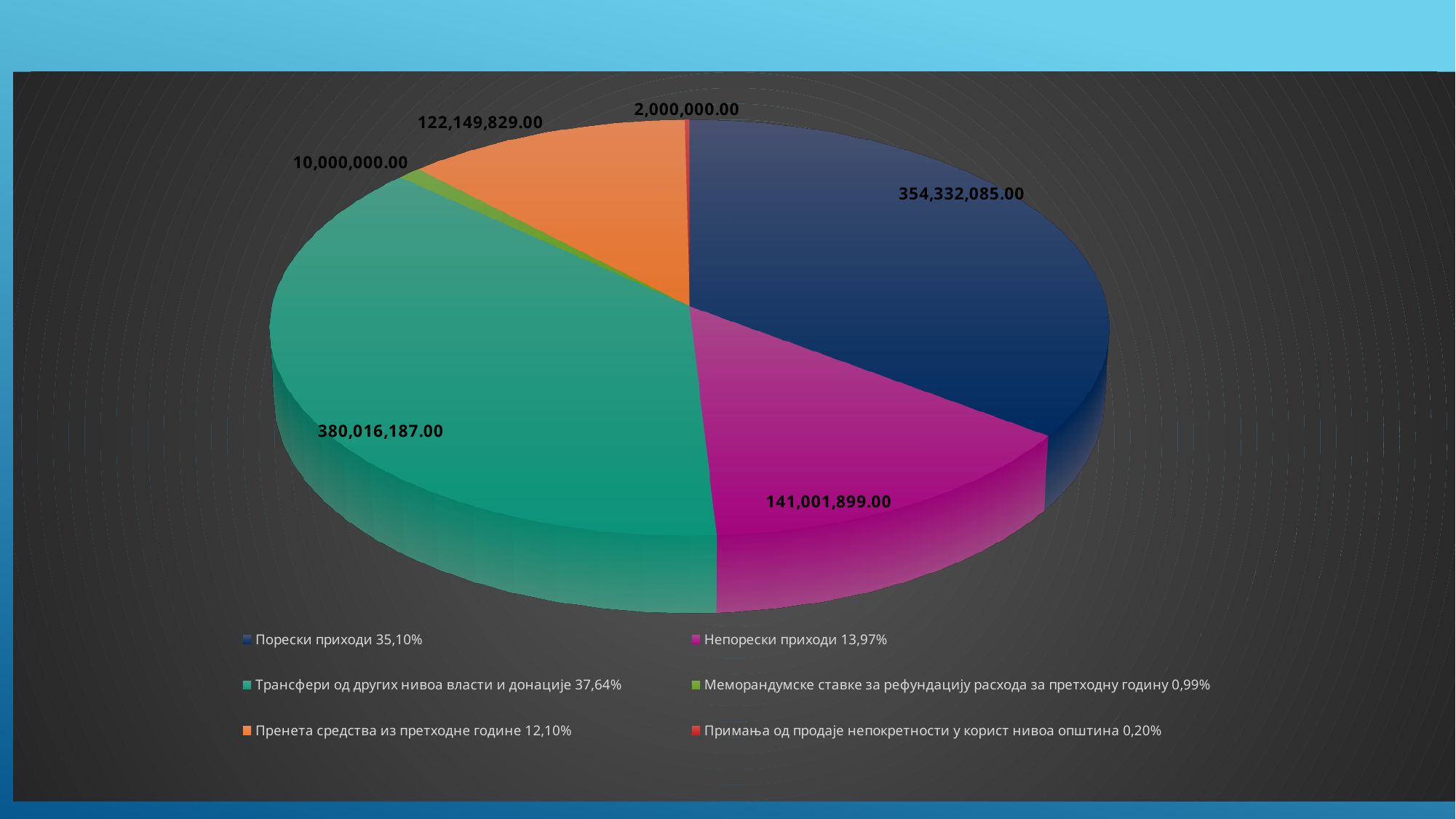
What is the value of the Непорески приходи slice? 141,001,899.00 What is the difference between the Трансфери од других нивоа власти и донације value and the Порески приходи value? 25,684,102.00 What is the value of the Порески приходи slice? 354,332,085.00 How many slices does the pie chart have? 6 What is the value of the Трансфери од других нивоа власти и донације slice? 380,016,187.00 Which category has the largest slice of the pie? Трансфери од других нивоа власти и донације What type of chart is shown on the slide? pie chart What share of the pie does Пренета средства из претходне године represent, according to the legend? 12,10% What colour is the Непорески приходи slice? magenta Which is larger, the Порески приходи slice or the Непорески приходи slice? Порески приходи Which category has the smallest slice of the pie? Примања од продаје непокретности у корист нивоа општина What is the value of the Пренета средства из претходне године slice? 122,149,829.00